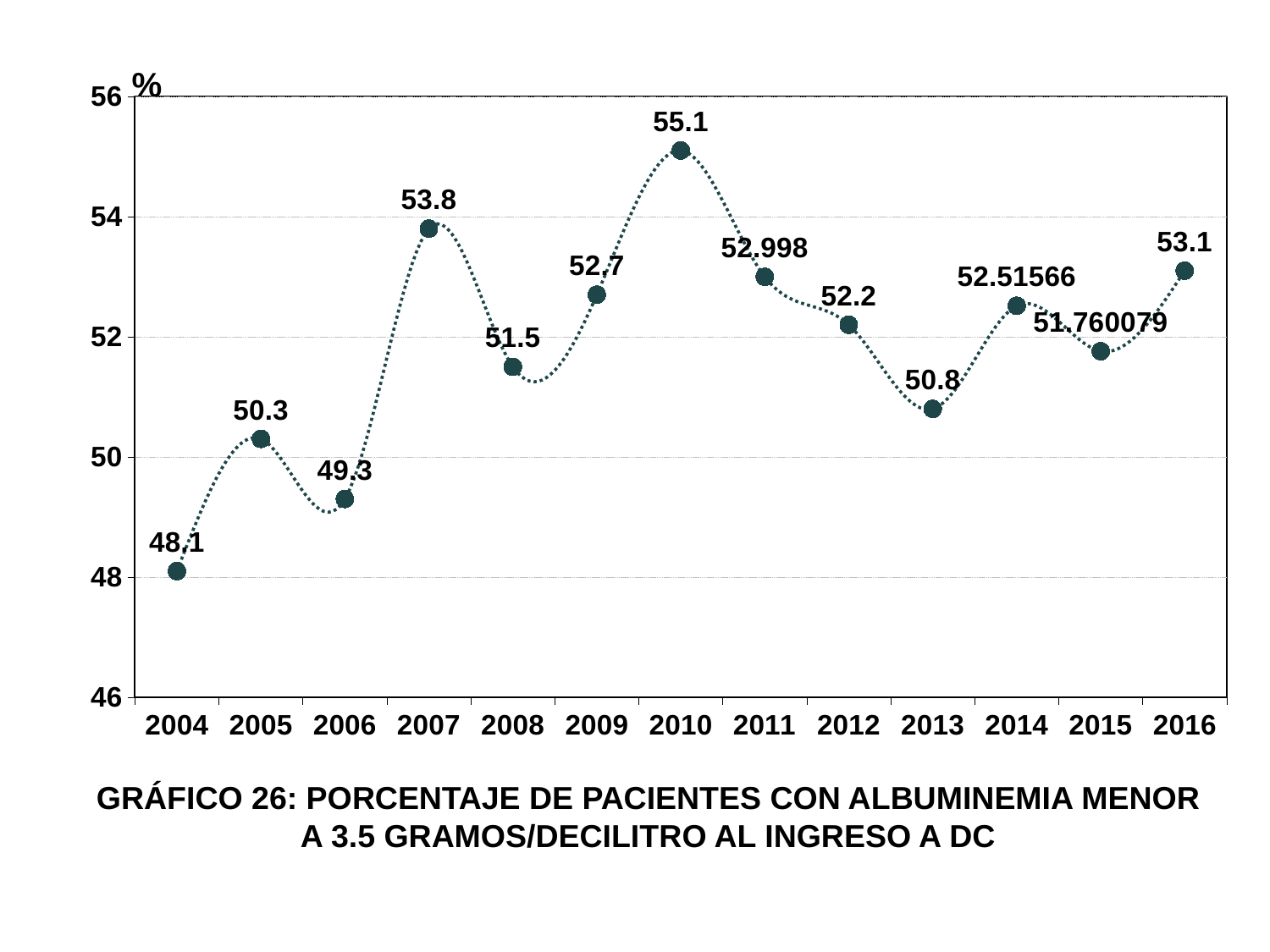
What is the value for 2004? 48.1 Which year has the highest value? 2010 What is the value for 2010? 55.1 Does the value rise or fall from 2010 to 2013? fall Which year has the lowest value? 2004 How many years are plotted on the chart? 13 What is the value for 2014? 52.51566 Which is larger, the value for 2007 or the value for 2009? 2007 What is the difference between the values for 2010 and 2004? 7 What kind of chart is this? line chart Is the value for 2013 greater or less than 52? less What is the value for 2016? 53.1